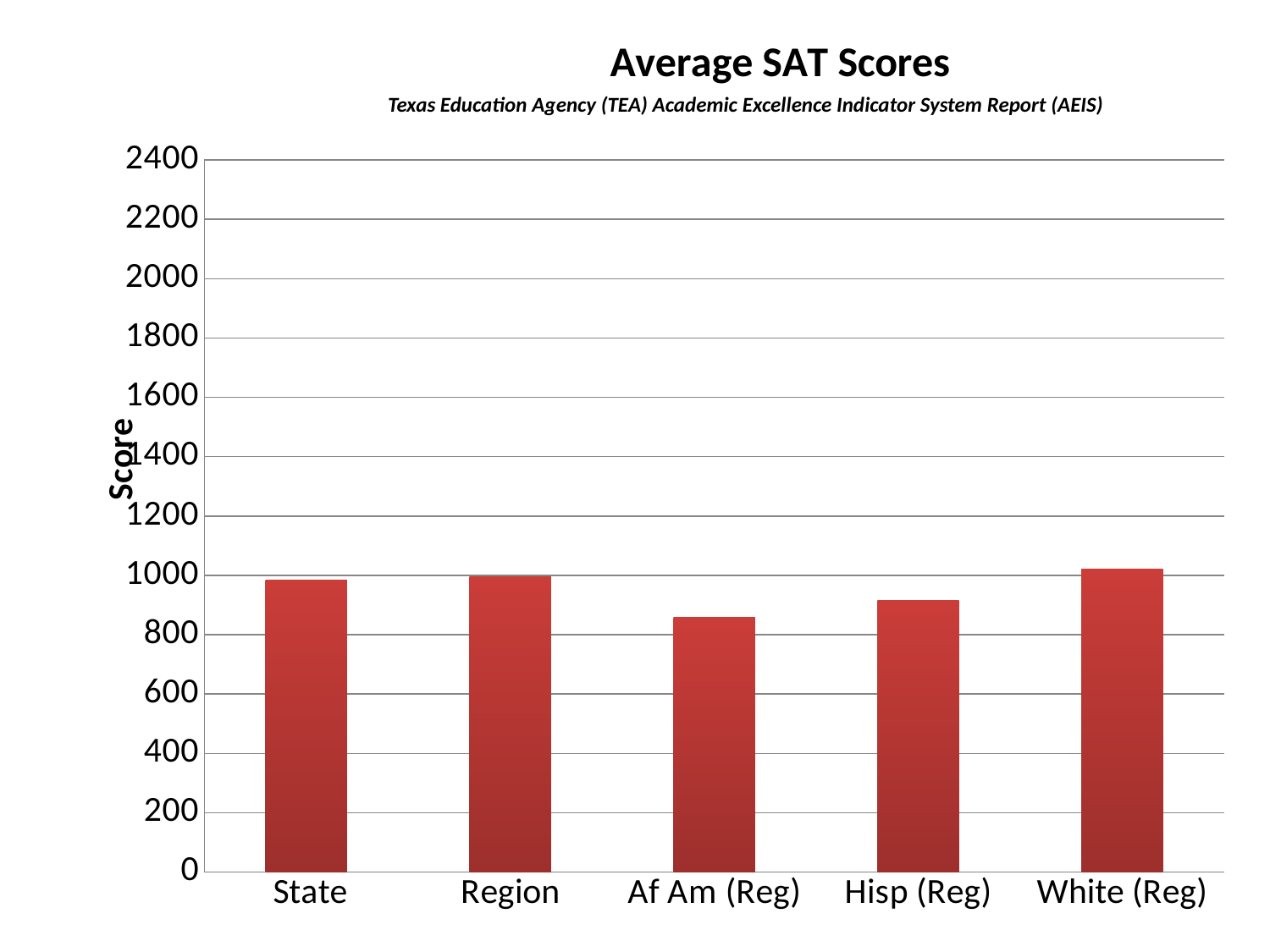
Which category has the highest average SAT score? White (Reg) Is the value for Hisp (Reg) greater or less than 1000? less Is the value for Af Am (Reg) greater or less than 1000? less Which category has the lowest average SAT score? Af Am (Reg) Is the value for White (Reg) greater or less than 1200? less What is the title of the chart? Average SAT Scores What kind of chart is shown on the slide? bar chart Which is larger, the value for Hisp (Reg) or the value for Af Am (Reg)? Hisp (Reg) Which is larger, the value for White (Reg) or the value for Af Am (Reg)? White (Reg) How many categories are shown on the x axis? 5 What is the label on the vertical axis? Score